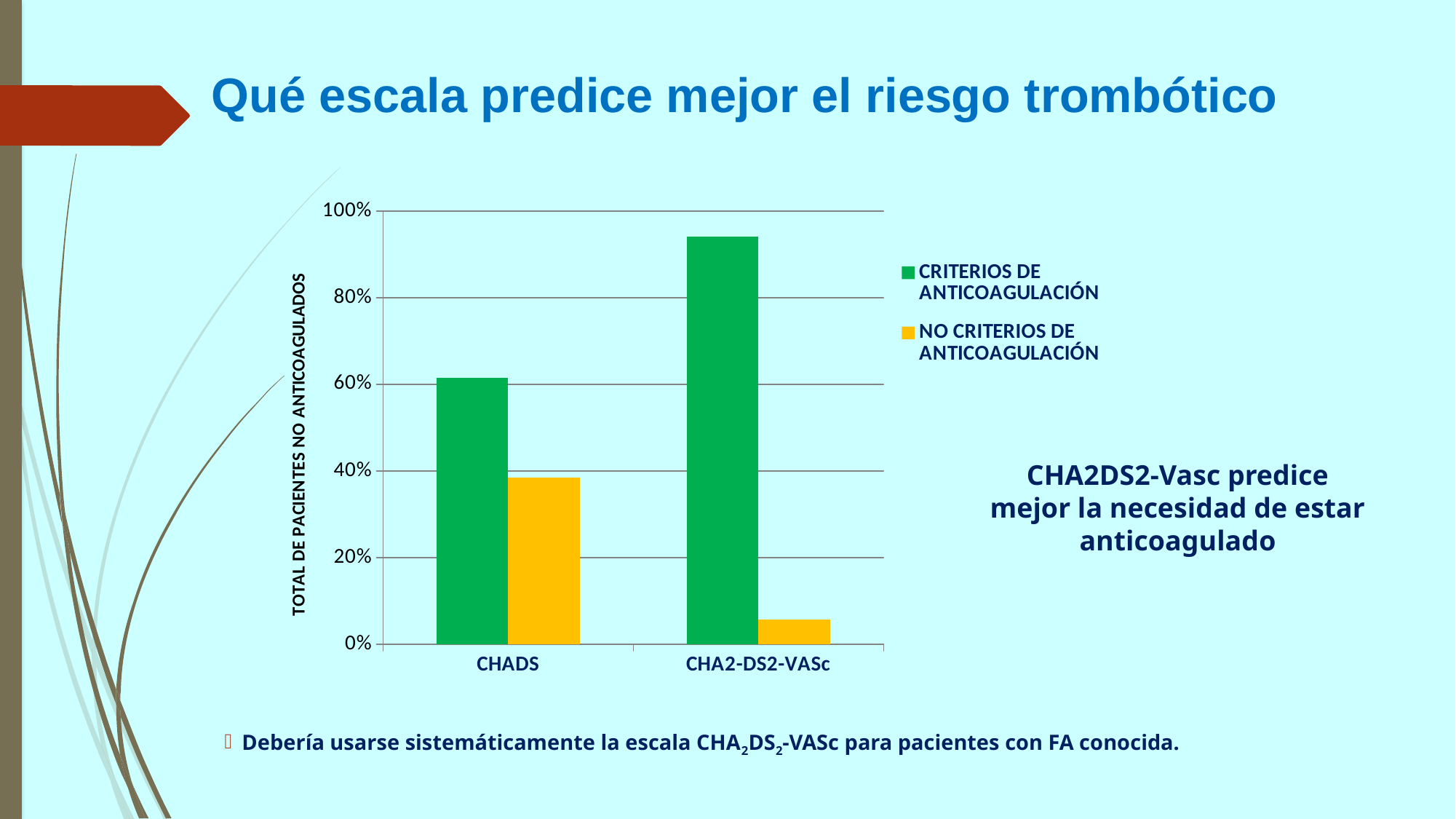
Which category has the lowest value for NO CRITERIOS DE ANTICOAGULACIÓN? CHA2-DS2-VASc What colour represents the NO CRITERIOS DE ANTICOAGULACIÓN series in the chart? yellow Which category has the highest value for CRITERIOS DE ANTICOAGULACIÓN? CHA2-DS2-VASc Is the value for CRITERIOS DE ANTICOAGULACIÓN in CHADS greater or less than 40%? greater Is the value for NO CRITERIOS DE ANTICOAGULACIÓN in CHA2-DS2-VASc greater or less than 20%? less What is the label of the vertical axis of the chart? TOTAL DE PACIENTES NO ANTICOAGULADOS Is the value for CRITERIOS DE ANTICOAGULACIÓN in CHA2-DS2-VASc greater or less than 80%? greater How many series does the chart legend list? 2 What kind of chart is shown on the slide? bar chart How many categories are shown on the x axis of the chart? 2 Which is larger in the CHADS category: CRITERIOS DE ANTICOAGULACIÓN or NO CRITERIOS DE ANTICOAGULACIÓN? CRITERIOS DE ANTICOAGULACIÓN